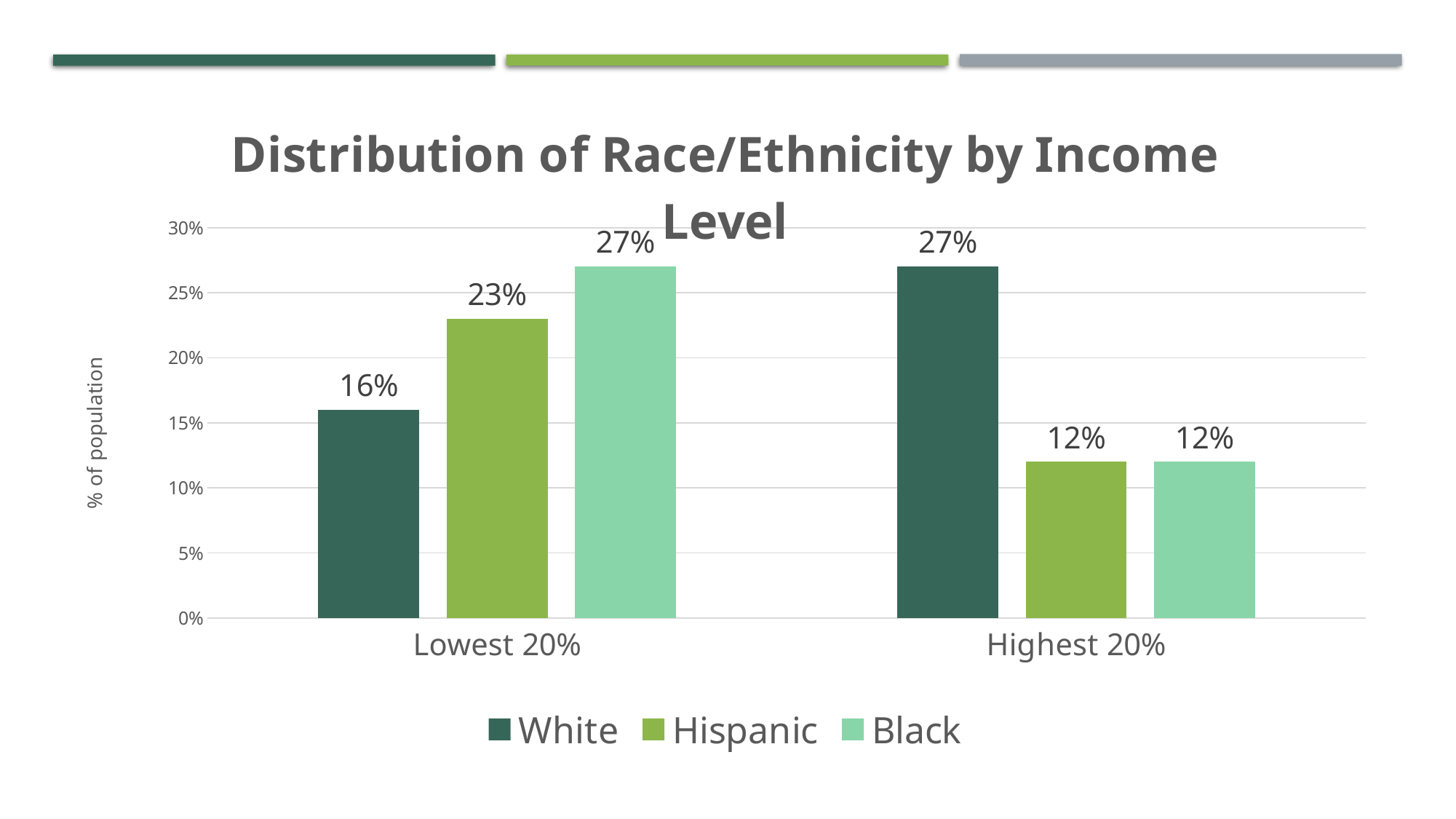
Which is larger: the Hispanic value for the Lowest 20% or the Hispanic value for the Highest 20%? Lowest 20% How many series does the legend list? 3 Which series has the highest value in the Lowest 20% income group? Black What kind of chart is shown on the slide? Bar chart What is the value for White in the Highest 20% income group? 27% What is the value for Hispanic in the Lowest 20% income group? 23% What is the value for White in the Lowest 20% income group? 16% How many income-level categories are shown on the x axis? 2 What is the label of the vertical axis? % of population What is the difference between the White values for the Highest 20% and the Lowest 20% income groups? 11% What is the value for Black in the Highest 20% income group? 12% Which series has the lowest value in the Highest 20% income group? Hispanic and Black (both 12%)